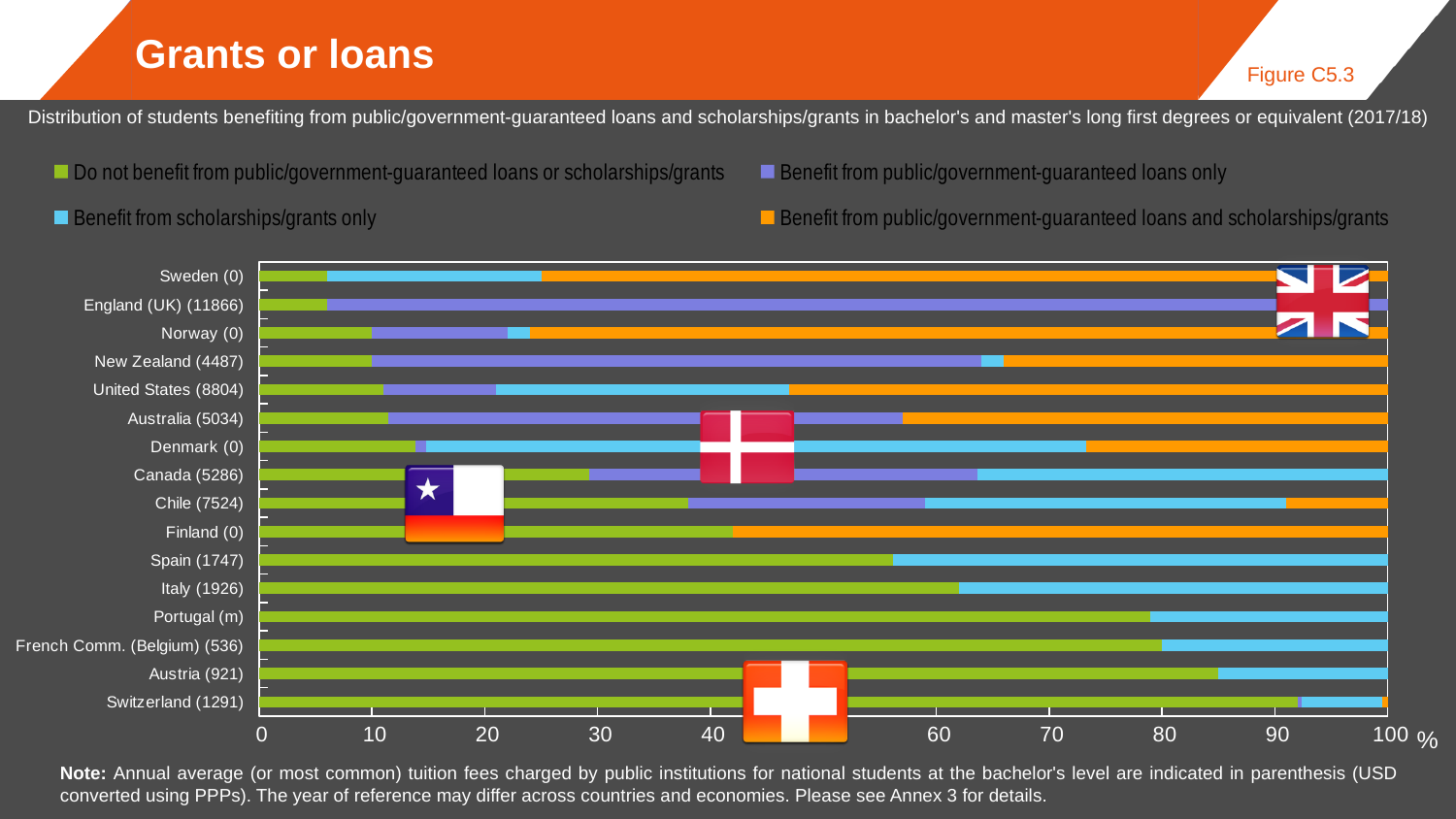
Which has a longer green segment, Spain (1747) or Denmark (0)? Spain (1747) Is the purple segment (loans only) for England (UK) (11866) greater or less than 80? greater Is the green segment for Italy (1926) greater or less than 60? greater Is the green segment for Sweden (0) greater or less than 10? less How many countries or economies are listed on the vertical axis of the chart? 16 Which country has the longest green segment (students who do not benefit from loans or grants)? Switzerland (1291) How many series does the legend list? 4 Going from the top of the chart to the bottom, do the green segments get longer or shorter? longer What is the figure number shown on the slide? Figure C5.3 What kind of chart is shown on the slide? Stacked bar chart